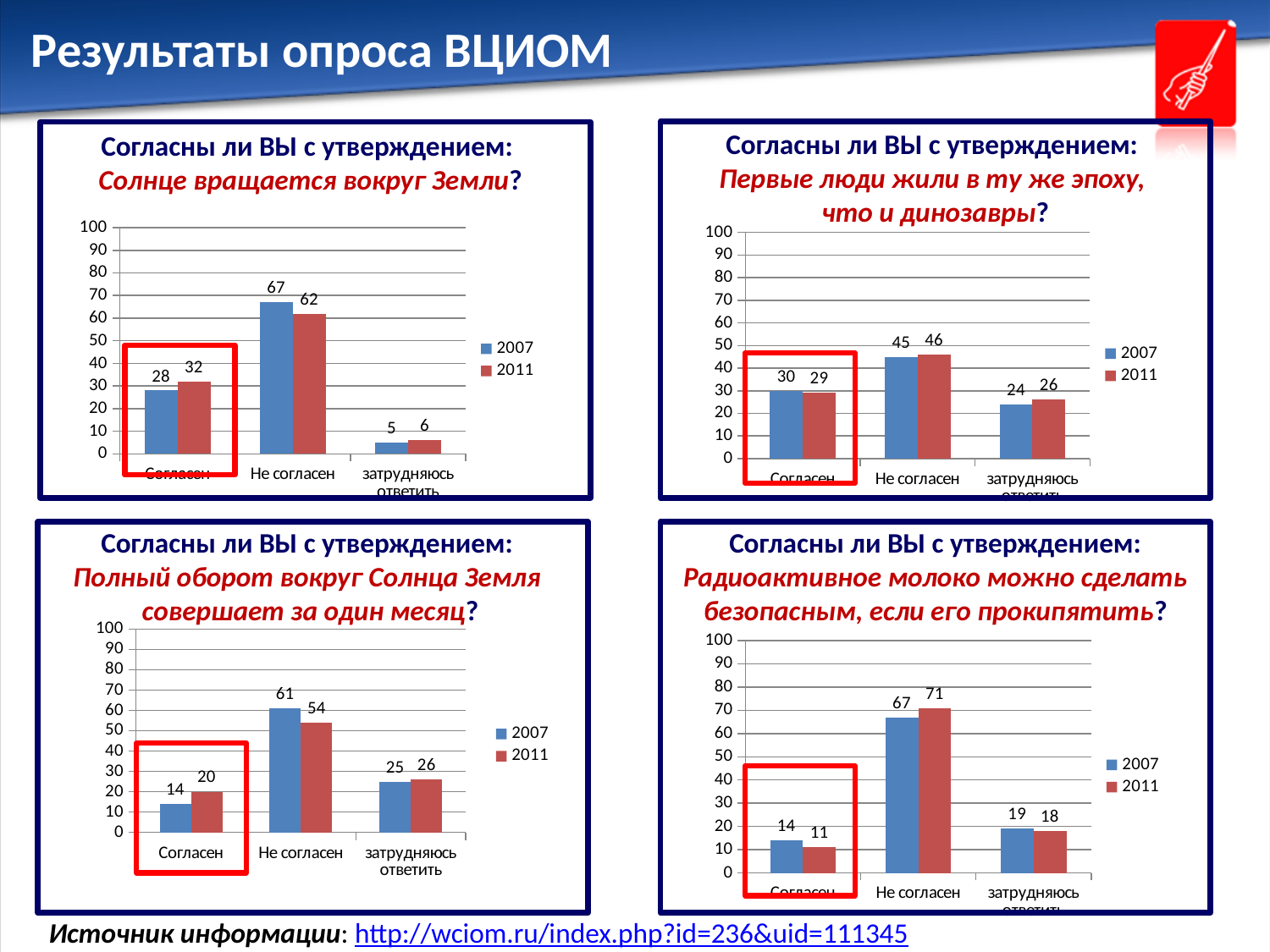
In the bottom-right chart (Радиоактивное молоко можно сделать безопасным, если его прокипятить?), what is the difference between the 2007 and 2011 values for 'Согласен'? 3 In the bottom-right chart (Радиоактивное молоко можно сделать безопасным, если его прокипятить?), which category has the lowest value in 2011? Согласен In the top-right chart (Первые люди жили в ту же эпоху, что и динозавры?), what is the value for 'затрудняюсь ответить' in 2007? 24 In the bottom-left chart (Полный оборот вокруг Солнца Земля совершает за один месяц?), which is larger for 'Не согласен': the 2007 value or the 2011 value? 2007 How many categories are shown on the x axis of the bottom-left chart (Полный оборот вокруг Солнца Земля совершает за один месяц?)? 3 In the bottom-left chart (Полный оборот вокруг Солнца Земля совершает за один месяц?), what is the value for 'Согласен' in 2007? 14 What kind of chart is the top-right chart (Первые люди жили в ту же эпоху, что и динозавры?)? Bar chart In the bottom-right chart (Радиоактивное молоко можно сделать безопасным, если его прокипятить?), what is the value for 'Не согласен' in 2011? 71 How many series does the legend list in the top-left chart (Солнце вращается вокруг Земли?)? 2 In the top-right chart (Первые люди жили в ту же эпоху, что и динозавры?), which category has the highest value in 2011? Не согласен In the top-left chart (Солнце вращается вокруг Земли?), what is the difference between the 2007 and 2011 values for 'Не согласен'? 5 In the top-left chart (Солнце вращается вокруг Земли?), what is the value for 'Согласен' in 2011? 32